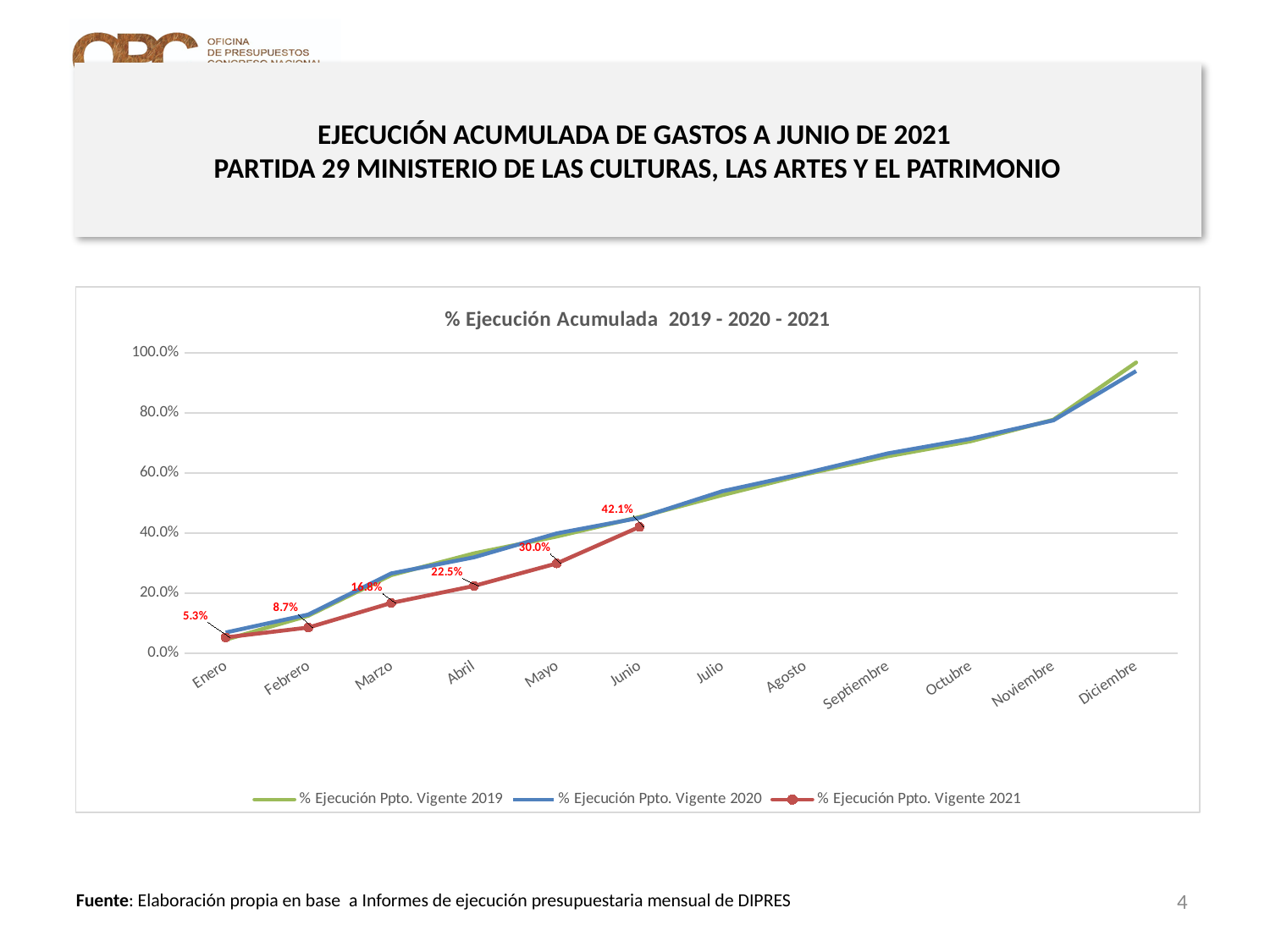
What is the difference between the Junio and Mayo values in the % Ejecución Ppto. Vigente 2021 series? 12.1% Do the values of the % Ejecución Ppto. Vigente 2021 series rise or fall from Enero to Junio? rise What is the value for Enero in the % Ejecución Ppto. Vigente 2021 series? 5.3% What is the value for Febrero in the % Ejecución Ppto. Vigente 2021 series? 8.7% How many series does the legend list? 3 What is the value for Junio in the % Ejecución Ppto. Vigente 2021 series? 42.1% Which month has the highest value in the % Ejecución Ppto. Vigente 2021 series? Junio What is the value for Abril in the % Ejecución Ppto. Vigente 2021 series? 22.5% Is the Diciembre value for % Ejecución Ppto. Vigente 2020 greater or less than 80.0%? greater How many months are shown along the x axis? 12 What kind of chart is shown on the slide? line chart What is the title of the chart? % Ejecución Acumulada 2019 - 2020 - 2021